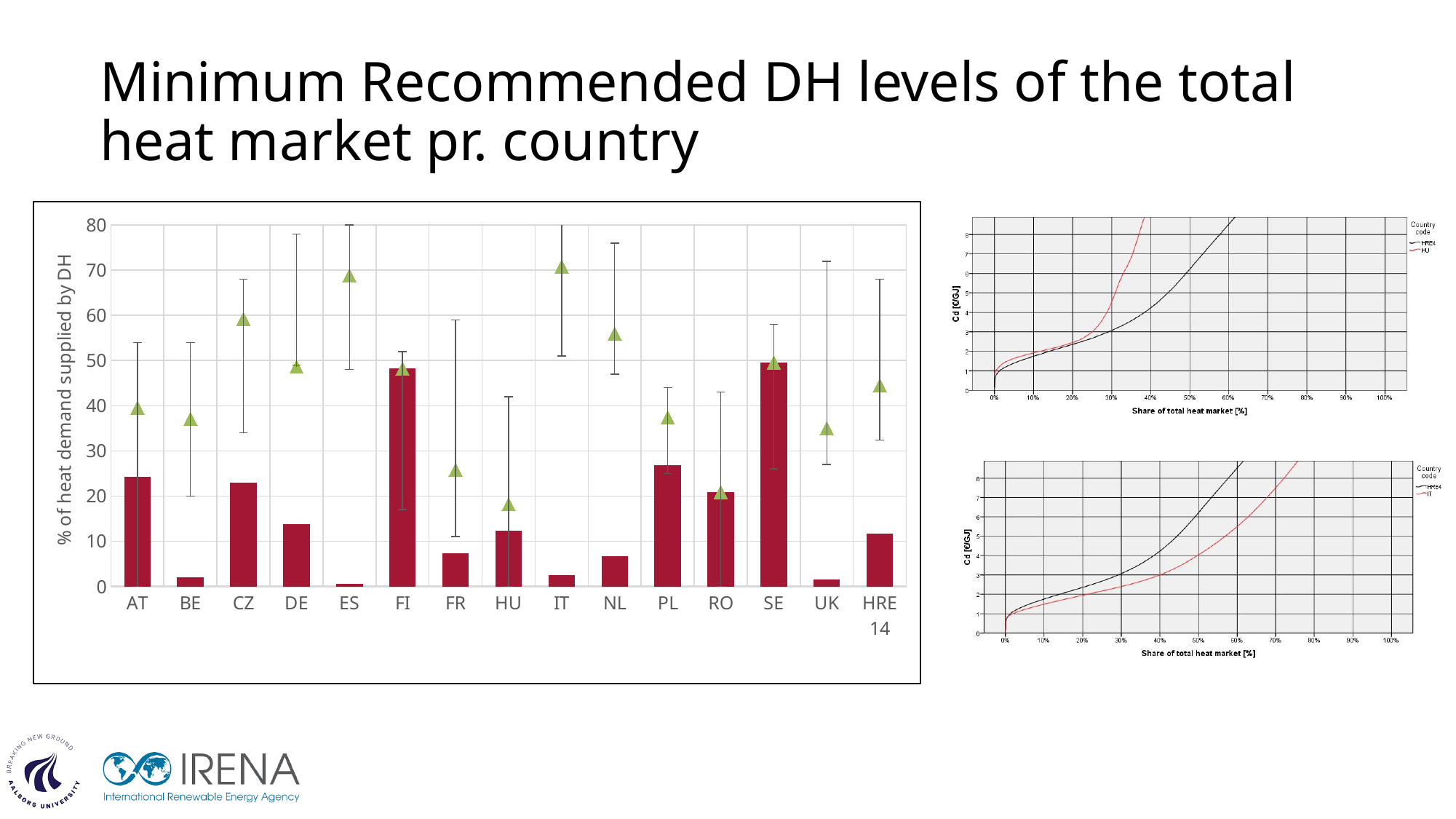
In the bar chart on the left, is the bar for AT greater or less than 20? greater What is the x-axis label of the two small line charts on the right of the slide? Share of total heat market [%] In the bar chart on the left, which bar is taller, FI or AT? FI In the bar chart on the left, which bar is taller, PL or HU? PL In the bar chart on the left, is the bar for FR greater or less than 10? less In the bar chart on the left, what is the label of the y axis? % of heat demand supplied by DH What kind of chart is the large chart on the left of the slide? bar chart In the bar chart on the left, is the bar for PL greater or less than 20? greater In the bar chart on the left, how many countries/categories are shown on the x axis? 15 In the bar chart on the left, which bar is taller, CZ or DE? CZ